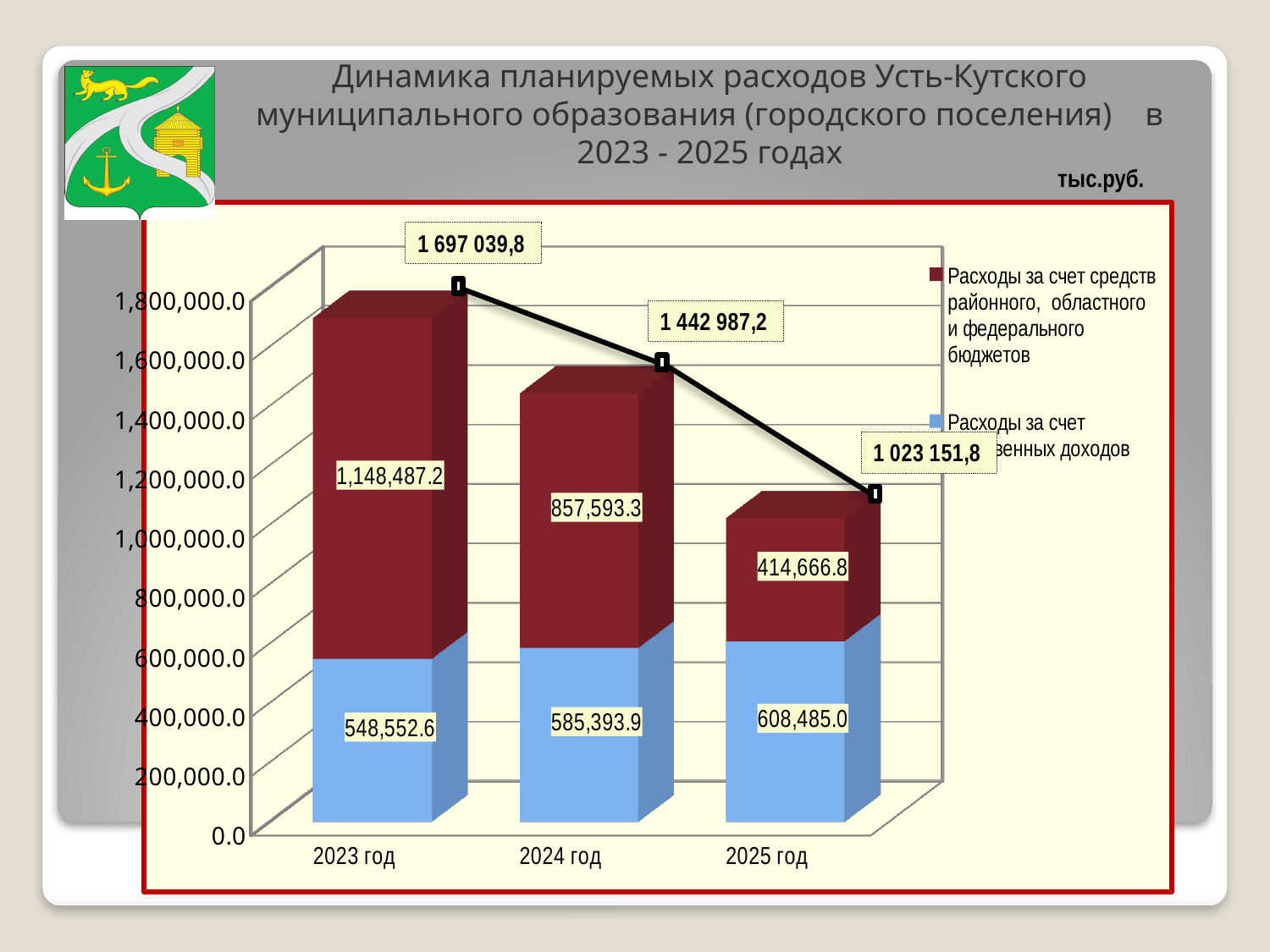
What total is labelled on the line above the bar for 2024 год? 1 442 987,2 How many series does the legend list? 2 What is the value of the blue series for 2025 год? 608,485.0 Do the total values shown on the line rise or fall from 2023 год to 2025 год? Fall What kind of chart is shown on the slide? Stacked bar chart For 2024 год, which is larger: the dark red series or the blue series? The dark red series (857,593.3) What is the value of the dark red series (Расходы за счет средств районного, областного и федерального бюджетов) for 2023 год? 1,148,487.2 By how much does the blue series value for 2025 год exceed its value for 2023 год? 59,932.4 By how much does the dark red series value for 2023 год exceed its value for 2025 год? 733,820.4 Which year has the highest total planned expenditure? 2023 год How many years are shown on the x axis? 3 Which year has the lowest value for the blue series? 2023 год